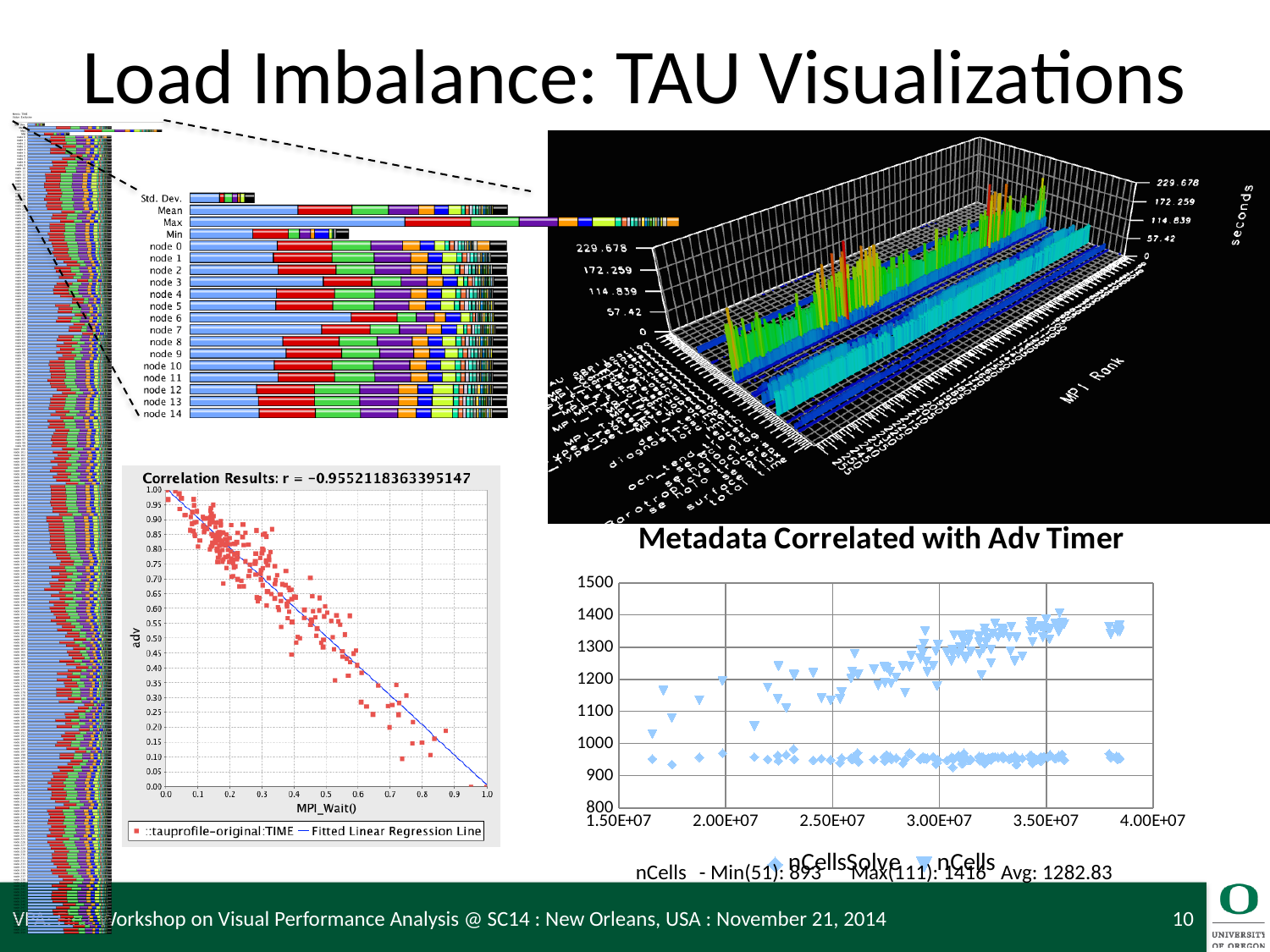
In the stacked bar chart at the upper left, how many node rows (node 0 through node 14) are plotted? 15 According to the text below the 'Metadata Correlated with Adv Timer' chart, what is the average nCells value? 1282.83 In the 'Metadata Correlated with Adv Timer' chart, do the nCells values rise or fall as the x-axis value increases? rise According to the text below the 'Metadata Correlated with Adv Timer' chart, what is the maximum nCells value? 1416 In the 'Metadata Correlated with Adv Timer' chart, what is the highest value shown on the y axis? 1500 In the scatter plot of adv versus MPI_Wait(), do the adv values rise or fall as MPI_Wait() increases? fall According to the text below the 'Metadata Correlated with Adv Timer' chart, what is the minimum nCells value? 893 How many series does the legend list in the 'Metadata Correlated with Adv Timer' chart? 2 What kind of chart is the chart at the upper left showing Std. Dev., Mean, Max, Min and node 0 to node 14? bar chart What is the label of the x axis in the scatter plot with the fitted linear regression line? MPI_Wait() What kind of chart is the 'Metadata Correlated with Adv Timer' chart? scatter chart What is the correlation coefficient r shown in the title of the scatter plot of adv versus MPI_Wait()? -0.9552118363395147